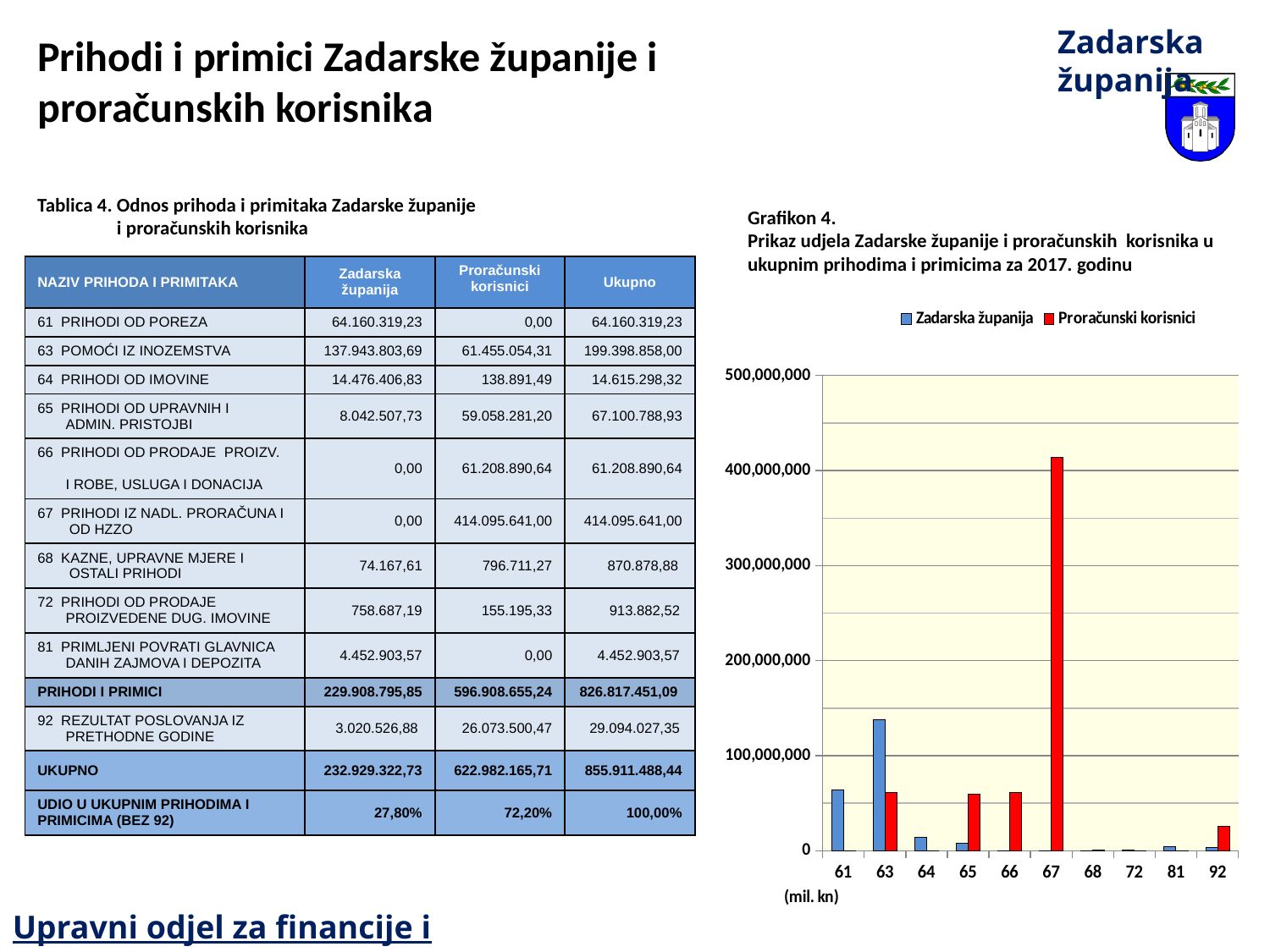
In Grafikon 4, is the Zadarska županija value for category 61 greater or less than 100,000,000? less How many series does the legend of Grafikon 4 list? 2 How many categories are shown on the x axis of Grafikon 4? 10 In Grafikon 4, is the Zadarska županija value for category 63 greater or less than 100,000,000? greater In Grafikon 4, which category has the tallest bar for Zadarska županija? 63 In Grafikon 4, for category 63, which series has the larger value: Zadarska županija or Proračunski korisnici? Zadarska županija In Grafikon 4, for category 65, which series has the larger value: Zadarska županija or Proračunski korisnici? Proračunski korisnici What kind of chart is Grafikon 4? bar chart In Grafikon 4, which colour represents the Zadarska županija series? blue In Grafikon 4, which colour represents the Proračunski korisnici series? red In Grafikon 4, is the Proračunski korisnici value for category 67 greater or less than 300,000,000? greater In Grafikon 4, which category has the tallest bar for Proračunski korisnici? 67